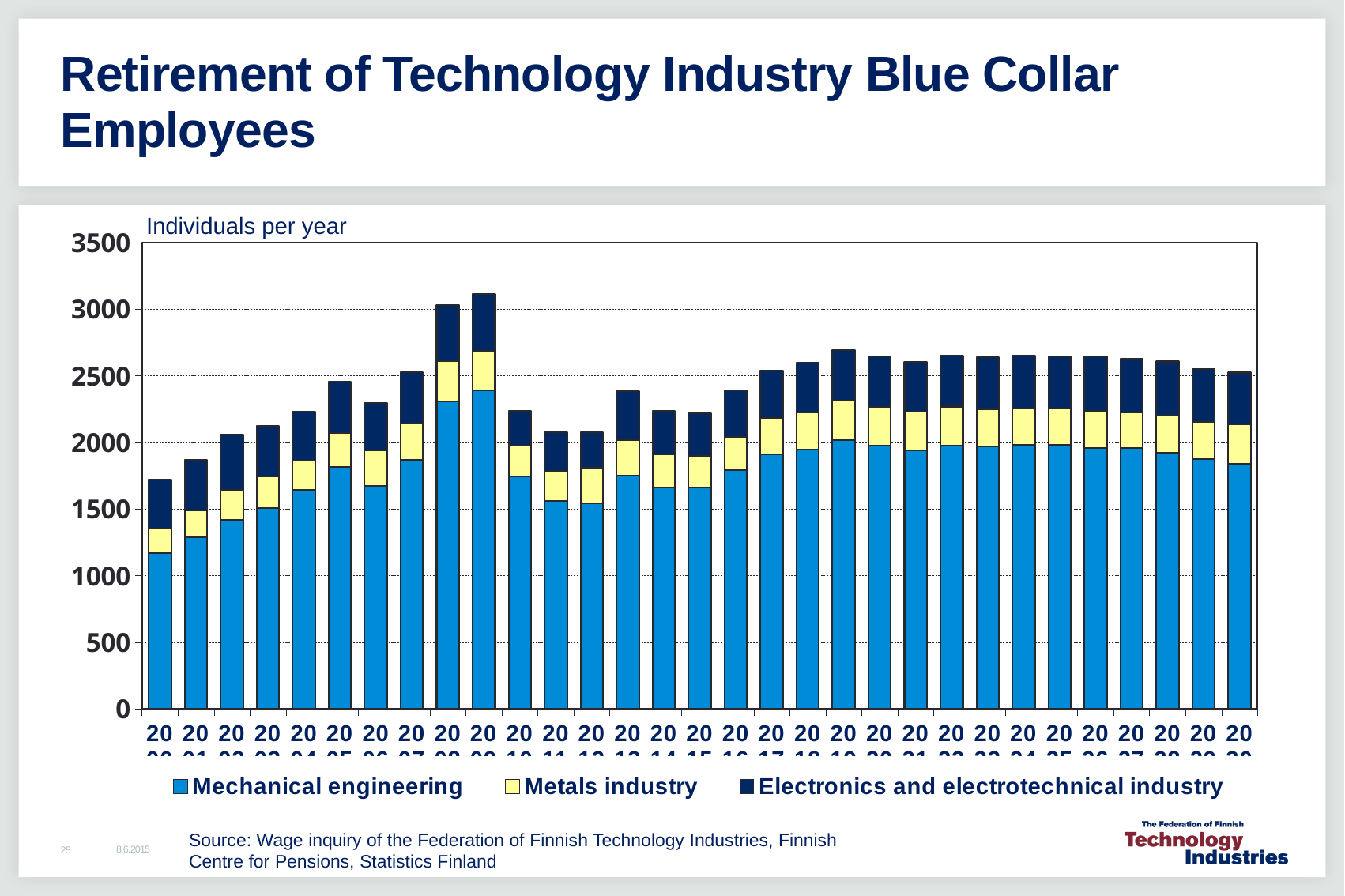
How many series does the legend list? 3 What label is printed above the vertical axis of the chart? Individuals per year Is the Mechanical engineering value in the leftmost bar greater or less than 1000? greater Which series is shown in dark navy blue in the legend? Electronics and electrotechnical industry Is the total of the tallest bar greater or less than 3000? greater Which has the larger total, the leftmost bar or the rightmost bar? The rightmost bar Which series forms the largest segment of every stacked bar? Mechanical engineering How many bars are plotted in the chart? 31 What kind of chart is shown on the slide? Stacked bar chart Is the total of the rightmost bar greater or less than 2000? greater Do the bar totals rise or fall from the leftmost bar to the tallest bar? Rise